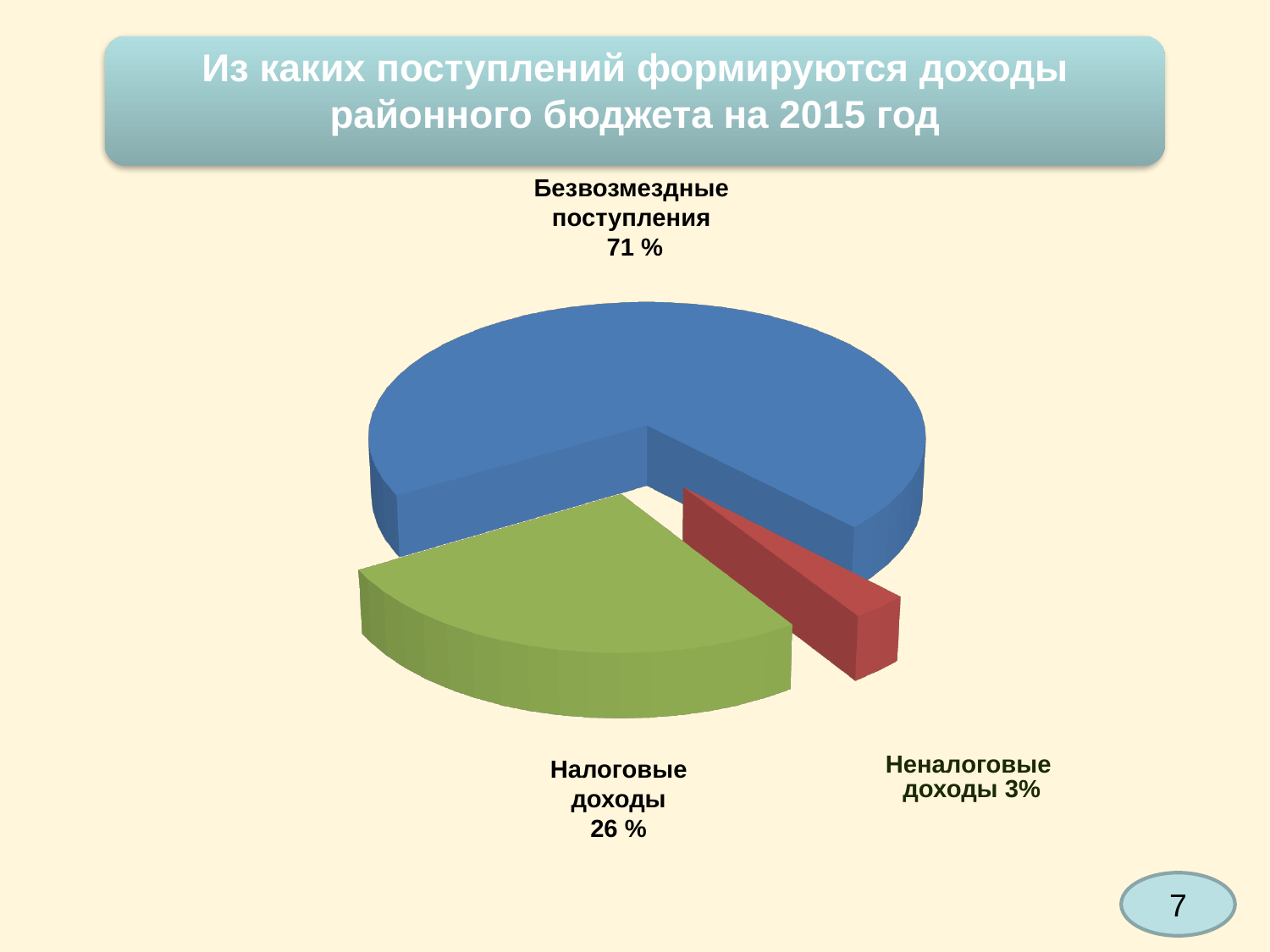
What colour is the slice for "Налоговые доходы"? green Which category has the smallest slice of the pie? Неналоговые доходы What is the difference in percentage points between "Налоговые доходы" and "Неналоговые доходы"? 23 How many slices does the pie chart have? 3 What share of the pie is labelled "Налоговые доходы"? 26 % What share of the pie is labelled "Неналоговые доходы"? 3% What is the title of the slide containing the chart? Из каких поступлений формируются доходы районного бюджета на 2015 год Which category has the largest slice of the pie? Безвозмездные поступления What kind of chart is shown on the slide? pie chart What is the difference in percentage points between "Безвозмездные поступления" and "Налоговые доходы"? 45 Which is larger: the share for "Налоговые доходы" or the share for "Неналоговые доходы"? Налоговые доходы What share of the pie is labelled "Безвозмездные поступления"? 71 %